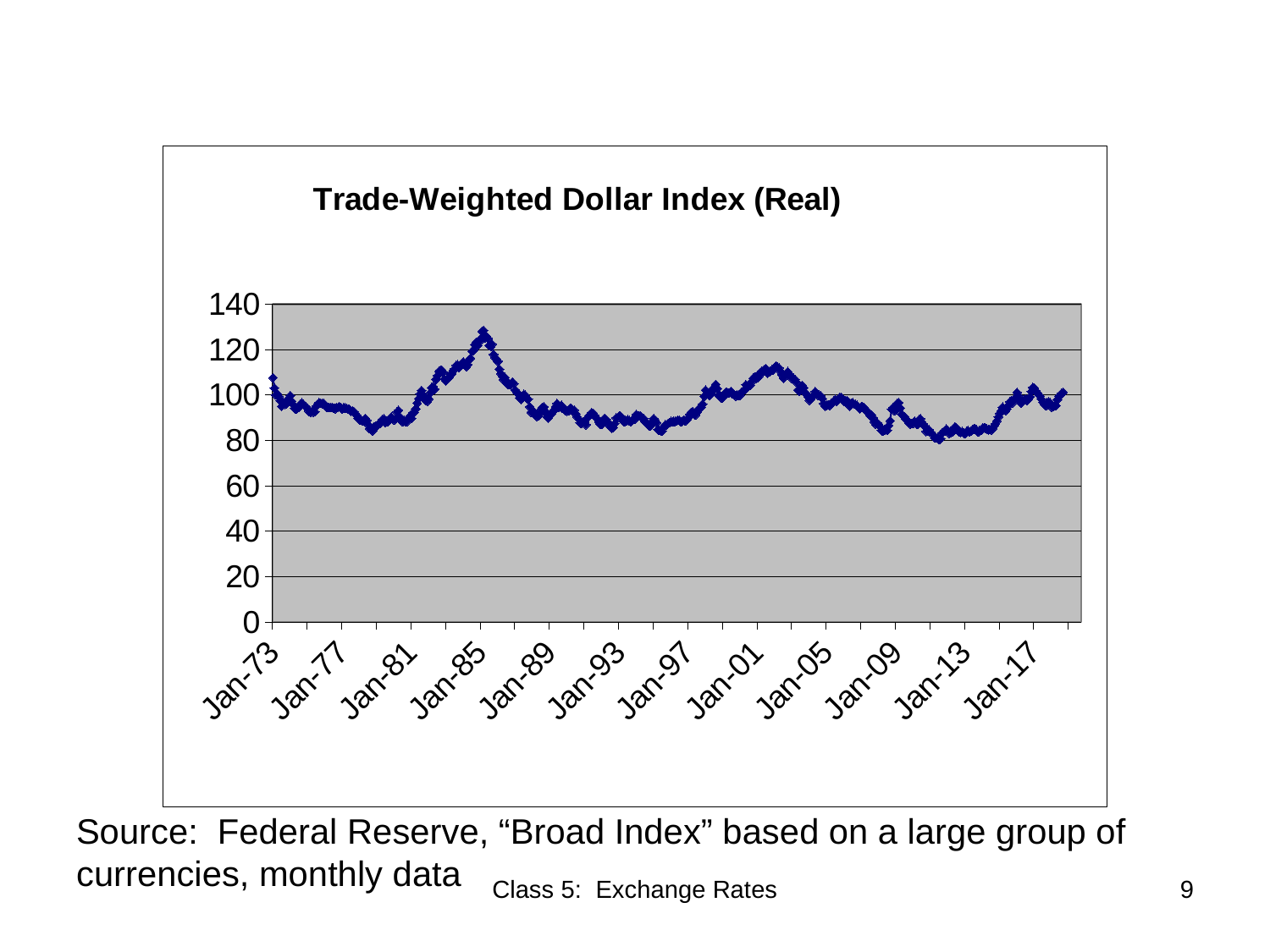
Is the highest value of the Trade-Weighted Dollar Index greater or less than 120? greater How many date labels are shown along the x axis of the chart? 12 What is the highest value shown on the vertical axis of the chart? 140 Around which x-axis label does the Trade-Weighted Dollar Index reach its highest point? Jan-85 Does the Trade-Weighted Dollar Index rise or fall between Jan-81 and Jan-85? rise Does the Trade-Weighted Dollar Index rise or fall between Jan-85 and Jan-89? fall Is the value of the index at Jan-73 greater or less than 100? greater Is the value of the index at Jan-93 greater or less than 100? less What kind of chart is shown on the slide? line chart Around which x-axis label does the Trade-Weighted Dollar Index reach its lowest point? Jan-13 What is the title of the chart? Trade-Weighted Dollar Index (Real)